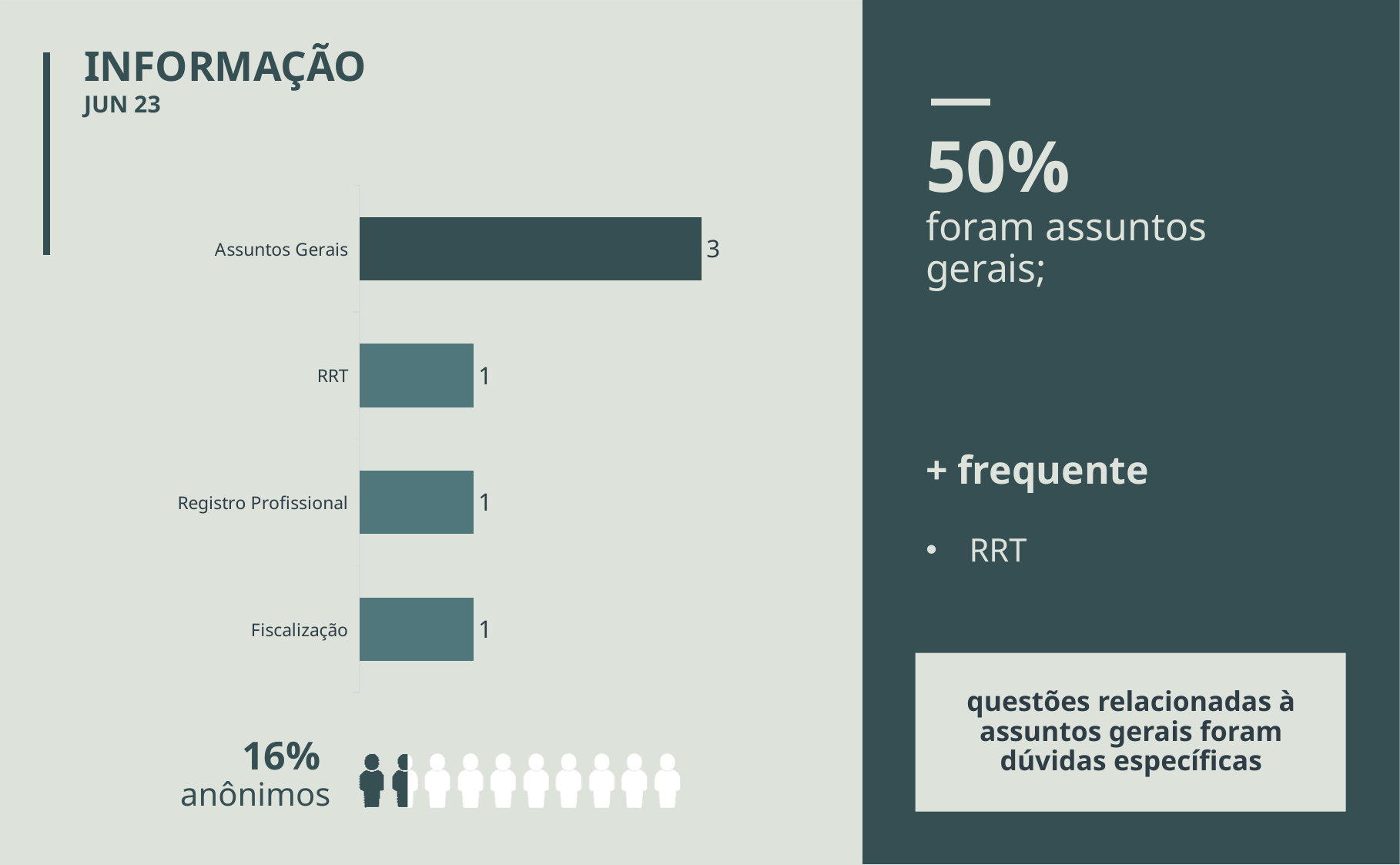
What is the value for Registro Profissional? 1 What is the value for Assuntos Gerais? 3 What kind of chart is shown on the slide? Bar chart Which category's bar is shown in a darker colour than the others? Assuntos Gerais Which category is listed at the top of the chart? Assuntos Gerais What is the difference between the values for Assuntos Gerais and RRT? 2 How many categories are shown in the chart? 4 What is the value for RRT? 1 Which category has the highest value? Assuntos Gerais What is the value for Fiscalização? 1 What is the total of all the values shown in the chart? 6 Which is larger, the value for Assuntos Gerais or the value for Fiscalização? Assuntos Gerais